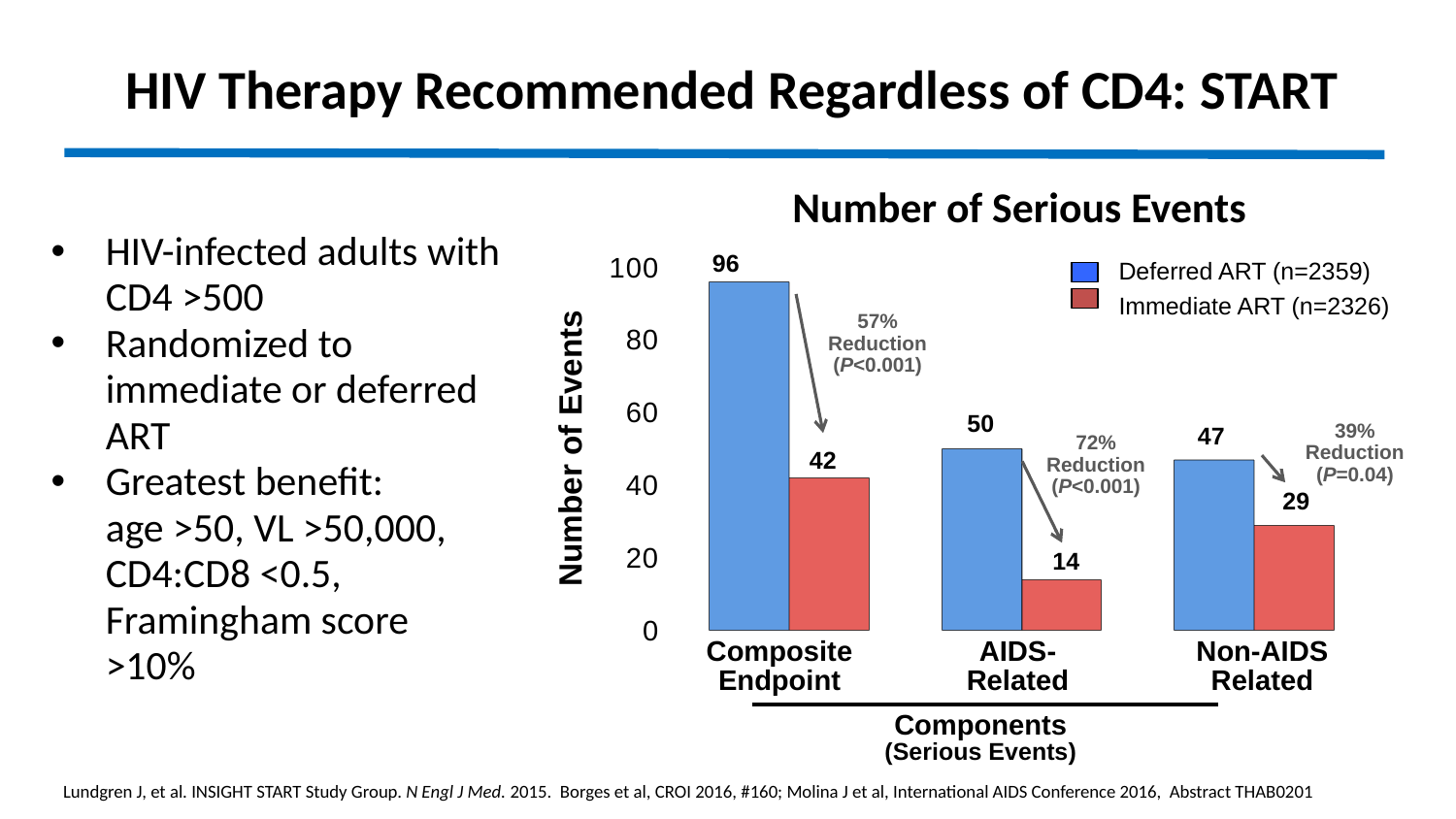
Is the value for Immediate ART in the Composite Endpoint category greater or less than 60? less What is the number of serious events for Immediate ART in the AIDS-Related category? 14 Which category has the highest number of events for Deferred ART? Composite Endpoint What is the difference between Deferred ART and Immediate ART events in the Composite Endpoint category? 54 What is the number of serious events for Immediate ART in the Non-AIDS Related category? 29 Which category has the lowest number of events for Immediate ART? AIDS-Related Which is larger: Deferred ART events in the AIDS-Related category or Deferred ART events in the Non-AIDS Related category? AIDS-Related What kind of chart is shown on the slide? bar chart How many series does the legend list? 2 What is the difference between Deferred ART and Immediate ART events in the Non-AIDS Related category? 18 How many categories are shown on the x axis of the chart? 3 What is the number of serious events for Deferred ART in the Composite Endpoint category? 96